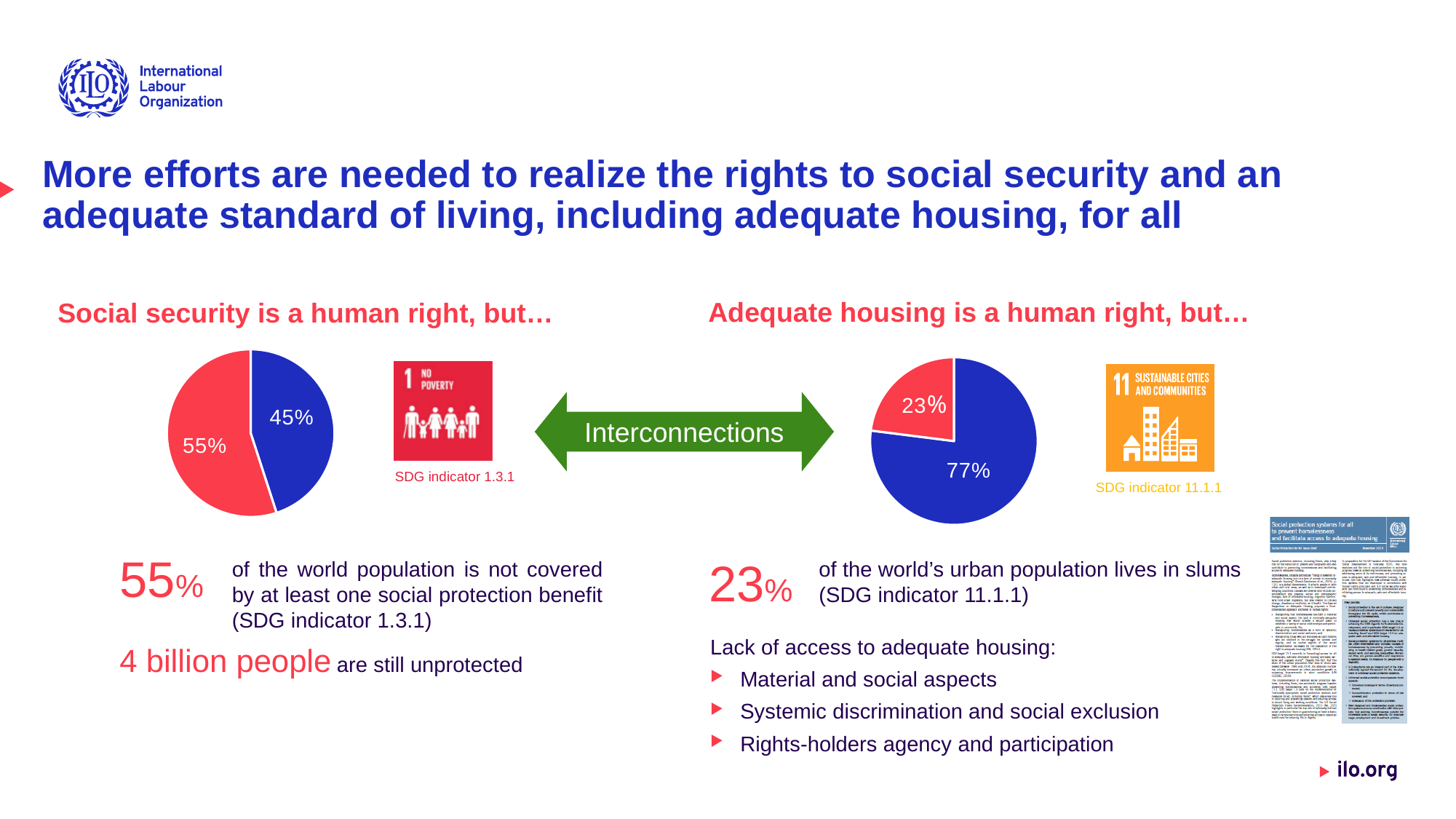
In the right pie chart, what percentage is shown on the blue slice? 77% In the left pie chart, what percentage is shown on the red slice? 55% In the left pie chart, which slice is larger, the red one or the blue one? the red one How many slices does the left pie chart have? 2 Which SDG indicator is cited next to the right pie chart? SDG indicator 11.1.1 What kind of chart is shown under the heading 'Social security is a human right, but…'? pie chart What kind of chart is shown under the heading 'Adequate housing is a human right, but…'? pie chart In the left pie chart, what percentage is shown on the blue slice? 45% In the right pie chart, what is the difference between the blue slice and the red slice? 54 percentage points In the right pie chart, which slice is the smallest? the red slice (23%) In the left pie chart, what is the difference between the red slice and the blue slice? 10 percentage points In the right pie chart, what percentage is shown on the red slice? 23%